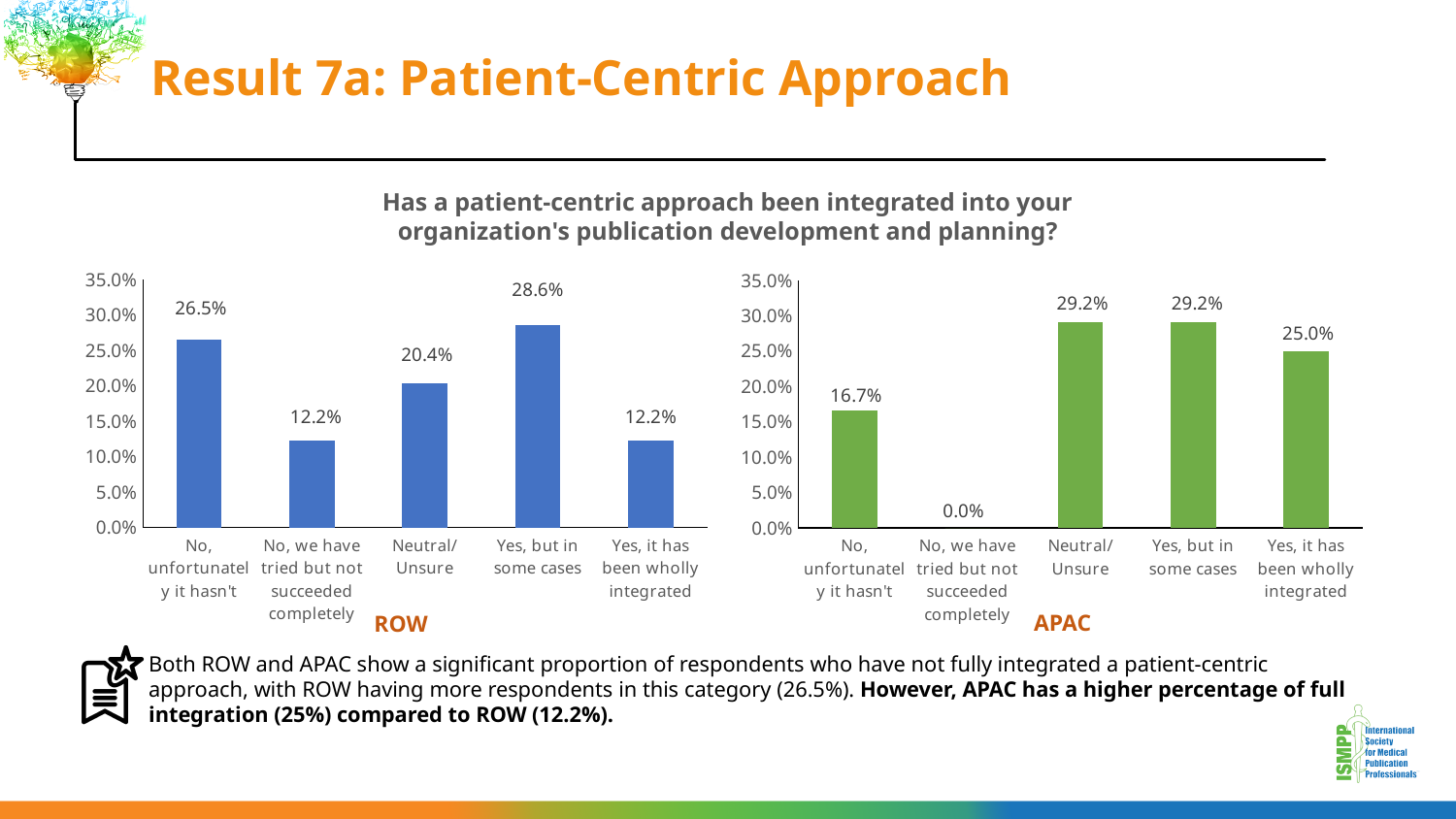
In the APAC chart, what is the difference between "Neutral/Unsure" and "Yes, it has been wholly integrated"? 4.2% What kind of chart is the ROW chart? bar chart In the ROW chart, which category has the highest value? Yes, but in some cases In the ROW chart, is the value for "Neutral/Unsure" greater or less than 25.0%? less In the ROW chart, what is the value for "No, we have tried but not succeeded completely"? 12.2% In the ROW chart, what is the difference between "No, unfortunately it hasn't" and "Yes, it has been wholly integrated"? 14.3% How many categories are shown in the APAC chart? 5 In the APAC chart, which category has the lowest value? No, we have tried but not succeeded completely In the APAC chart, what is the value for "No, unfortunately it hasn't"? 16.7% Which chart shows a higher value for "Yes, it has been wholly integrated", ROW or APAC? APAC What colour are the bars in the APAC chart? green In the ROW chart, what is the value for "Yes, but in some cases"? 28.6%